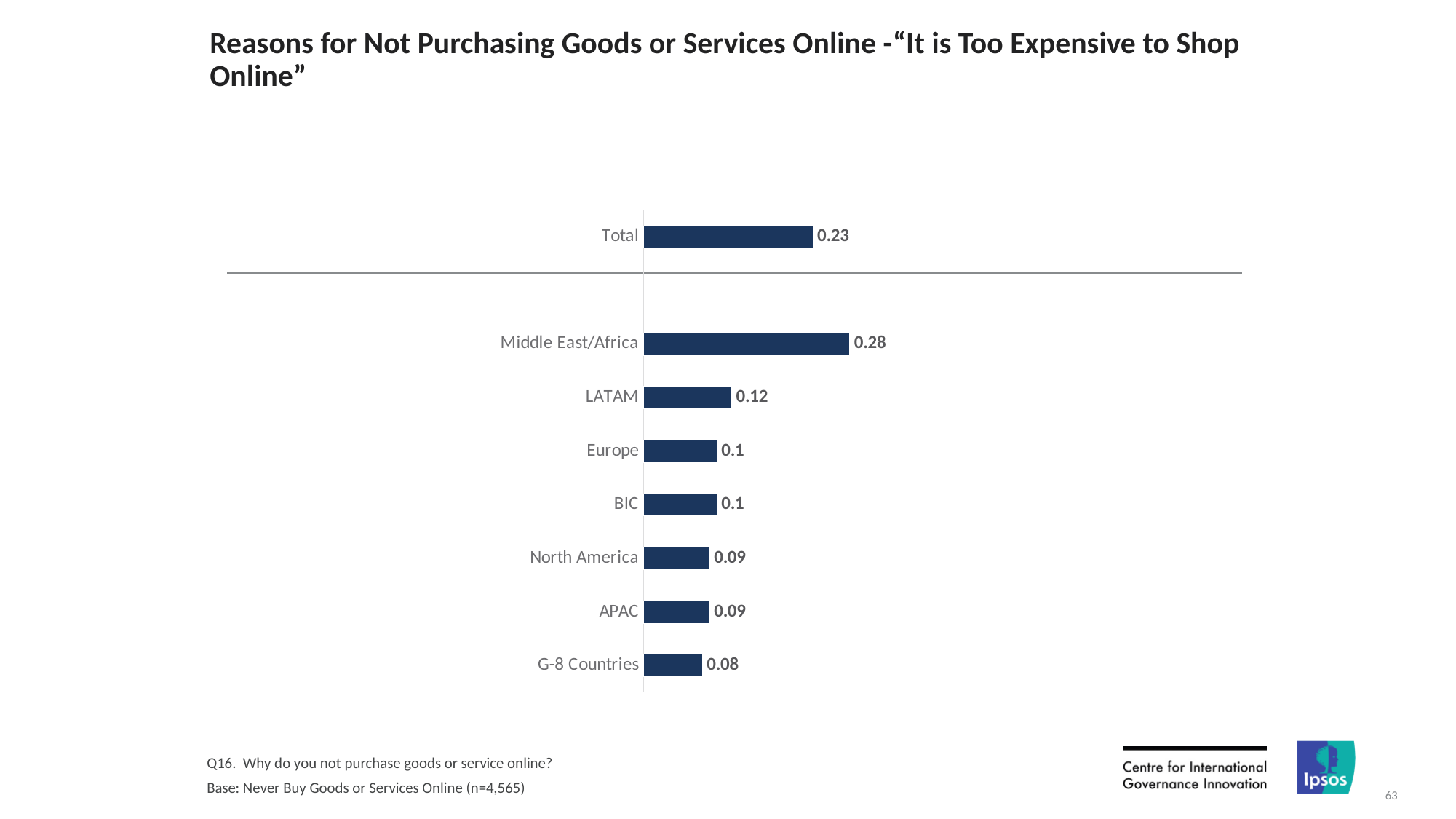
What kind of chart is shown on the slide? Bar chart What is the value for LATAM? 0.12 Which region has the highest value? Middle East/Africa How many categories are shown in the chart? 8 What is the difference between the values for Middle East/Africa and LATAM? 0.16 Which is larger, the value for LATAM or the value for North America? LATAM What is the value for APAC? 0.09 What is the value for G-8 Countries? 0.08 Which category has the lowest value? G-8 Countries What is the value for Total? 0.23 What is the value for Middle East/Africa? 0.28 What is the difference between the values for Total and Europe? 0.13